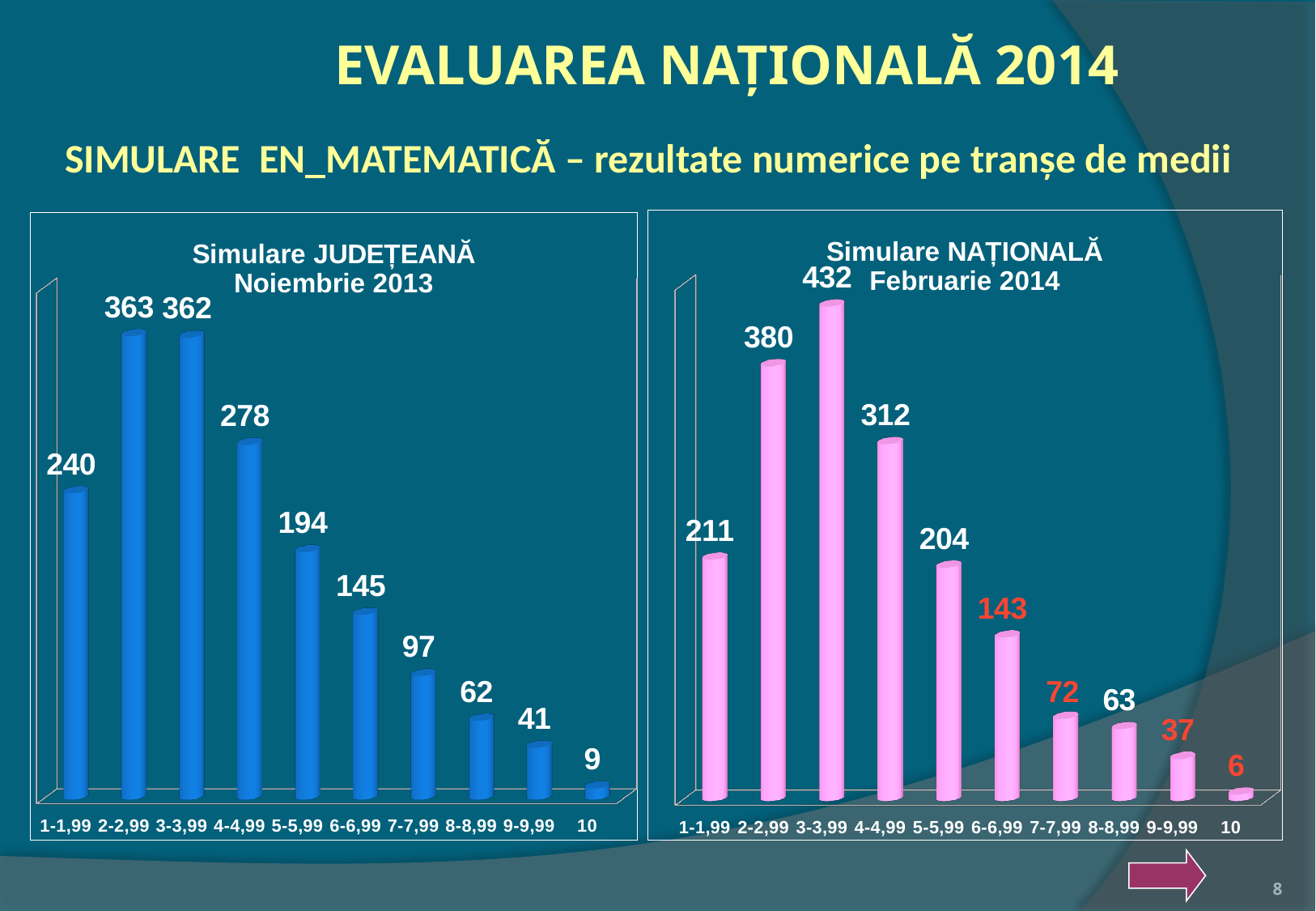
What colour are the bars in the Simulare NAȚIONALĂ Februarie 2014 chart? Pink What kind of chart is the Simulare NAȚIONALĂ Februarie 2014 chart? Bar chart How many bands (categories) are shown in the Simulare JUDEȚEANĂ Noiembrie 2013 chart? 10 In the Simulare JUDEȚEANĂ Noiembrie 2013 chart, which band has the lowest value? 10 In the Simulare NAȚIONALĂ Februarie 2014 chart, what is the difference between the values for 2-2,99 and 1-1,99? 169 In the Simulare NAȚIONALĂ Februarie 2014 chart, which is larger: the value for 7-7,99 or the value for 8-8,99? 7-7,99 Which is larger: the value for 1-1,99 in the Simulare JUDEȚEANĂ chart or the value for 1-1,99 in the Simulare NAȚIONALĂ chart? Simulare JUDEȚEANĂ (240) In the Simulare JUDEȚEANĂ Noiembrie 2013 chart, do the values rise or fall from the 3-3,99 band to the 10 band? Fall In the Simulare JUDEȚEANĂ Noiembrie 2013 chart, what is the difference between the values for 5-5,99 and 6-6,99? 49 In the Simulare NAȚIONALĂ Februarie 2014 chart, which band has the highest value? 3-3,99 In the Simulare JUDEȚEANĂ Noiembrie 2013 chart, what is the value for the 4-4,99 band? 278 In the Simulare NAȚIONALĂ Februarie 2014 chart, what is the value for the 6-6,99 band? 143